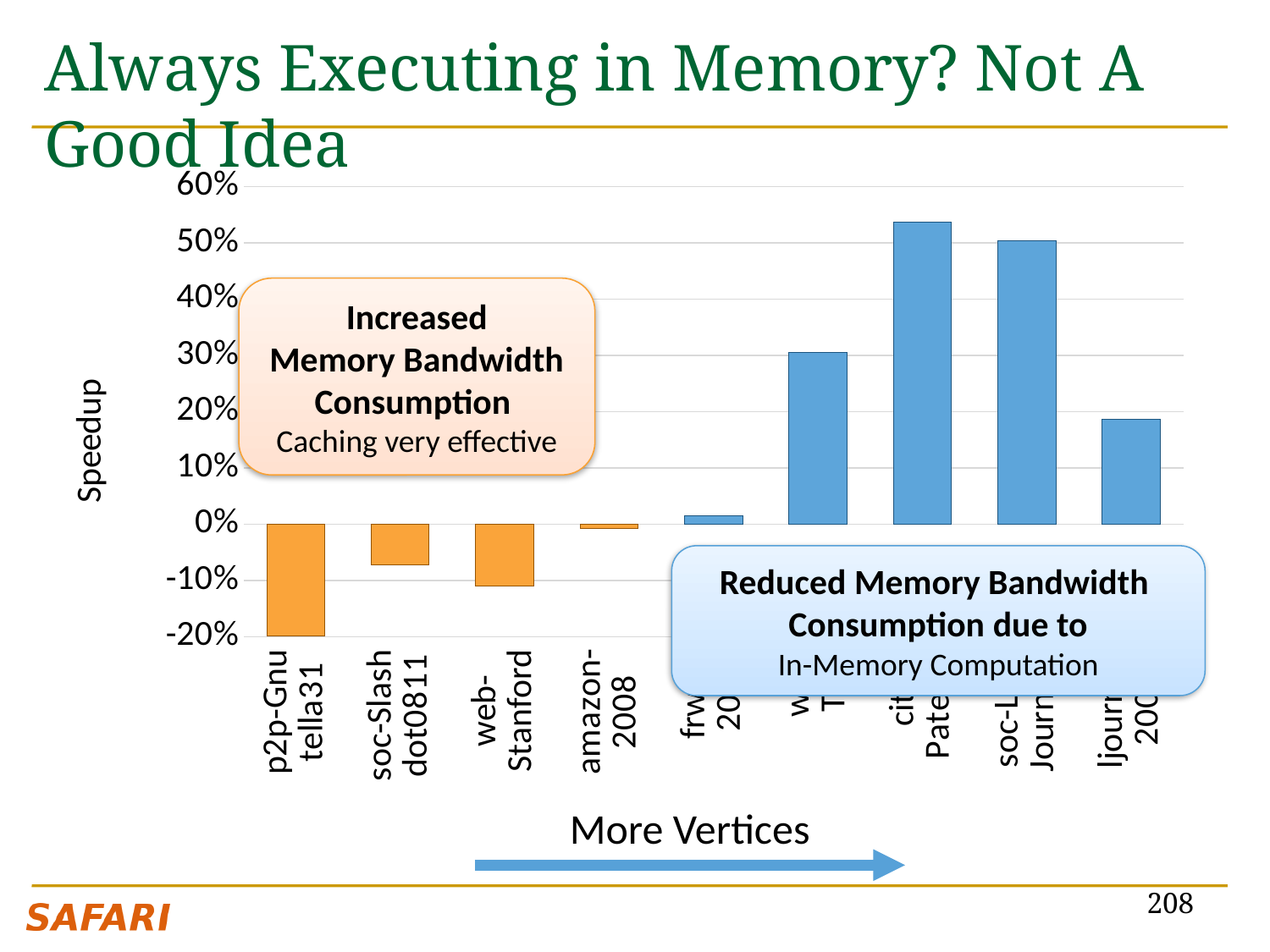
How many bars (categories) are plotted in the chart? 9 Do the speedup values generally rise or fall moving left to right along the x axis? rise Is the speedup for web-Stanford greater or less than 0%? less Is the speedup for p2p-Gnutella31 greater or less than -10%? less Is the speedup for soc-Slashdot0811 greater or less than -10%? greater Which has the larger speedup, soc-Slashdot0811 or web-Stanford? soc-Slashdot0811 How many bars in the chart show a negative speedup? 4 What is the label on the vertical axis of the chart? Speedup What kind of chart is shown on the slide? bar chart Which category has the lowest speedup in the chart? p2p-Gnutella31